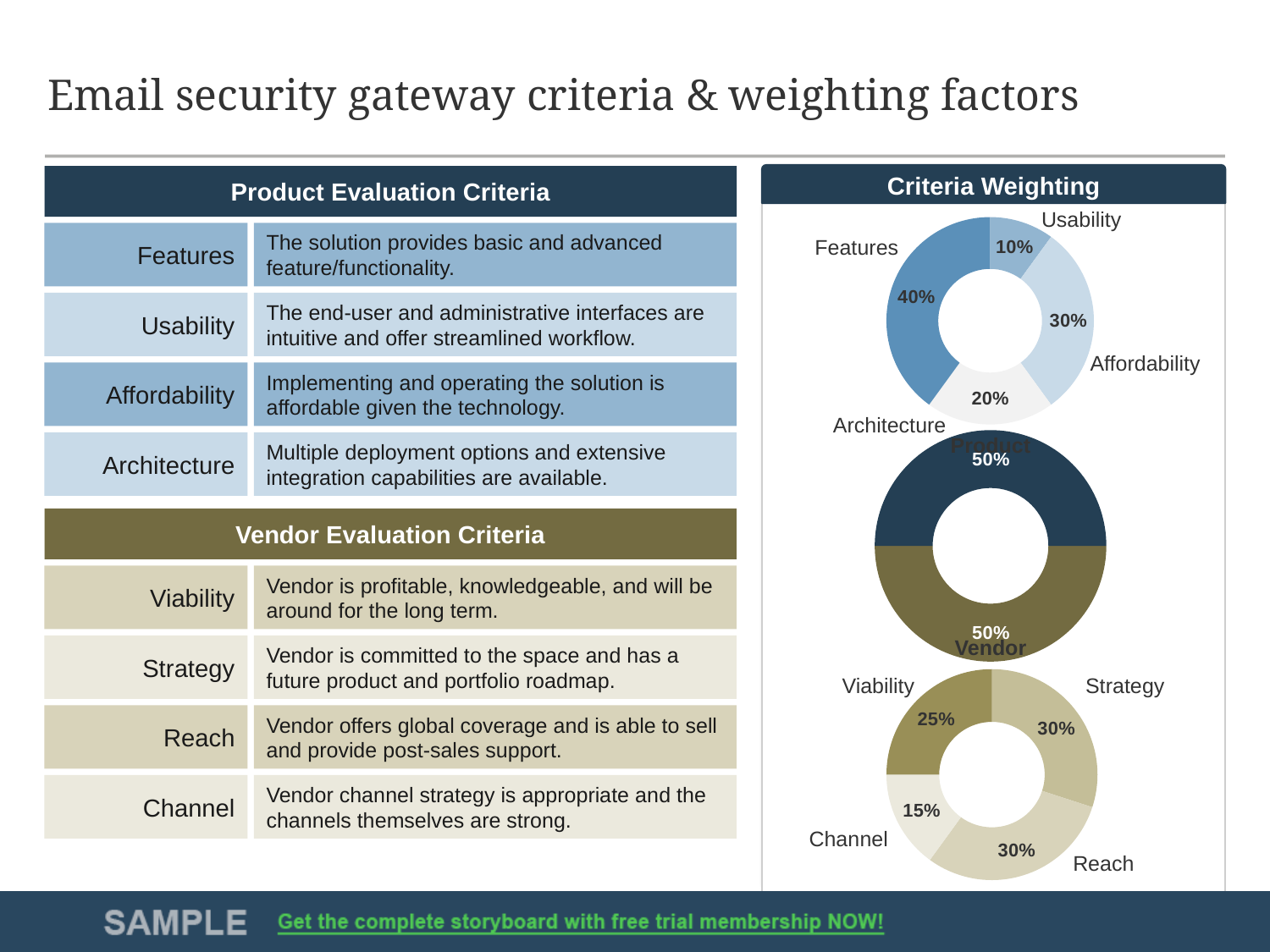
In the middle donut chart under Criteria Weighting, what is the weighting for Vendor? 50% How many slices does the middle donut chart under Criteria Weighting have? 2 How many slices does the bottom donut chart under Criteria Weighting have? 4 What type of chart is used for the Criteria Weighting charts? Donut (pie) chart In the bottom donut chart under Criteria Weighting, what is the weighting for Channel? 15% In the top donut chart under Criteria Weighting, which criterion has the lowest weighting? Usability In the top donut chart under Criteria Weighting, what is the weighting for Features? 40% In the top donut chart under Criteria Weighting, what is the difference between the Affordability and Architecture weightings? 10% In the top donut chart under Criteria Weighting, which criterion has the highest weighting? Features In the top donut chart under Criteria Weighting, what is the weighting for Usability? 10% In the bottom donut chart under Criteria Weighting, which is larger, the weighting for Viability or the weighting for Strategy? Strategy In the bottom donut chart under Criteria Weighting, which criterion has the lowest weighting? Channel